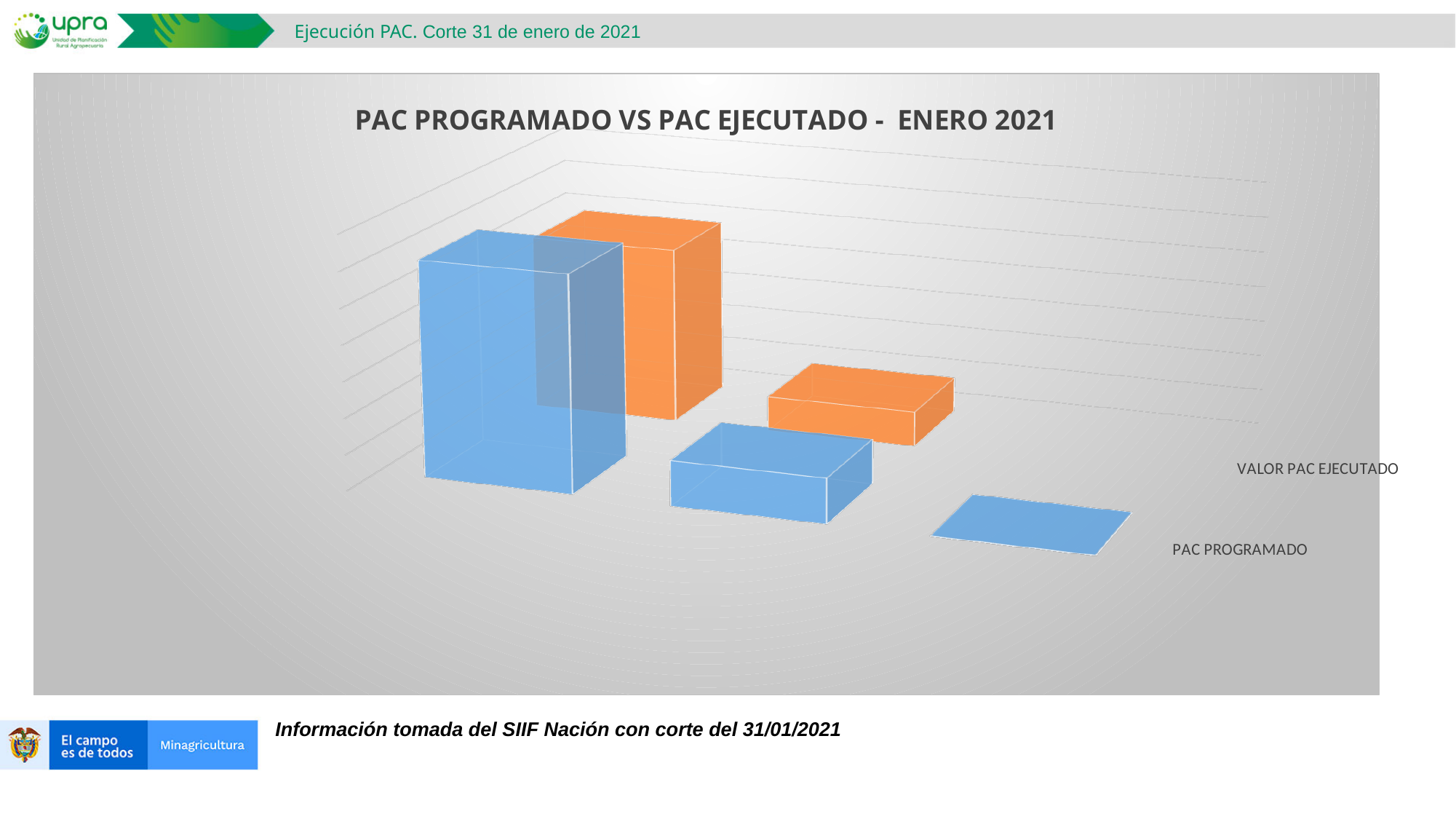
How many bars are plotted for the PAC PROGRAMADO series? 3 Which PAC PROGRAMADO bar is the tallest: the leftmost, the middle, or the rightmost? leftmost What kind of chart is shown on the slide? 3D bar chart Do the PAC PROGRAMADO bars rise or fall from left to right? fall What is the title of the chart on the slide? PAC PROGRAMADO VS PAC EJECUTADO - ENERO 2021 Which VALOR PAC EJECUTADO bar is taller: the leftmost or the middle one? leftmost Which series is drawn in blue? PAC PROGRAMADO Which PAC PROGRAMADO bar is the lowest: the leftmost, the middle, or the rightmost? rightmost How many series does the chart show? 2